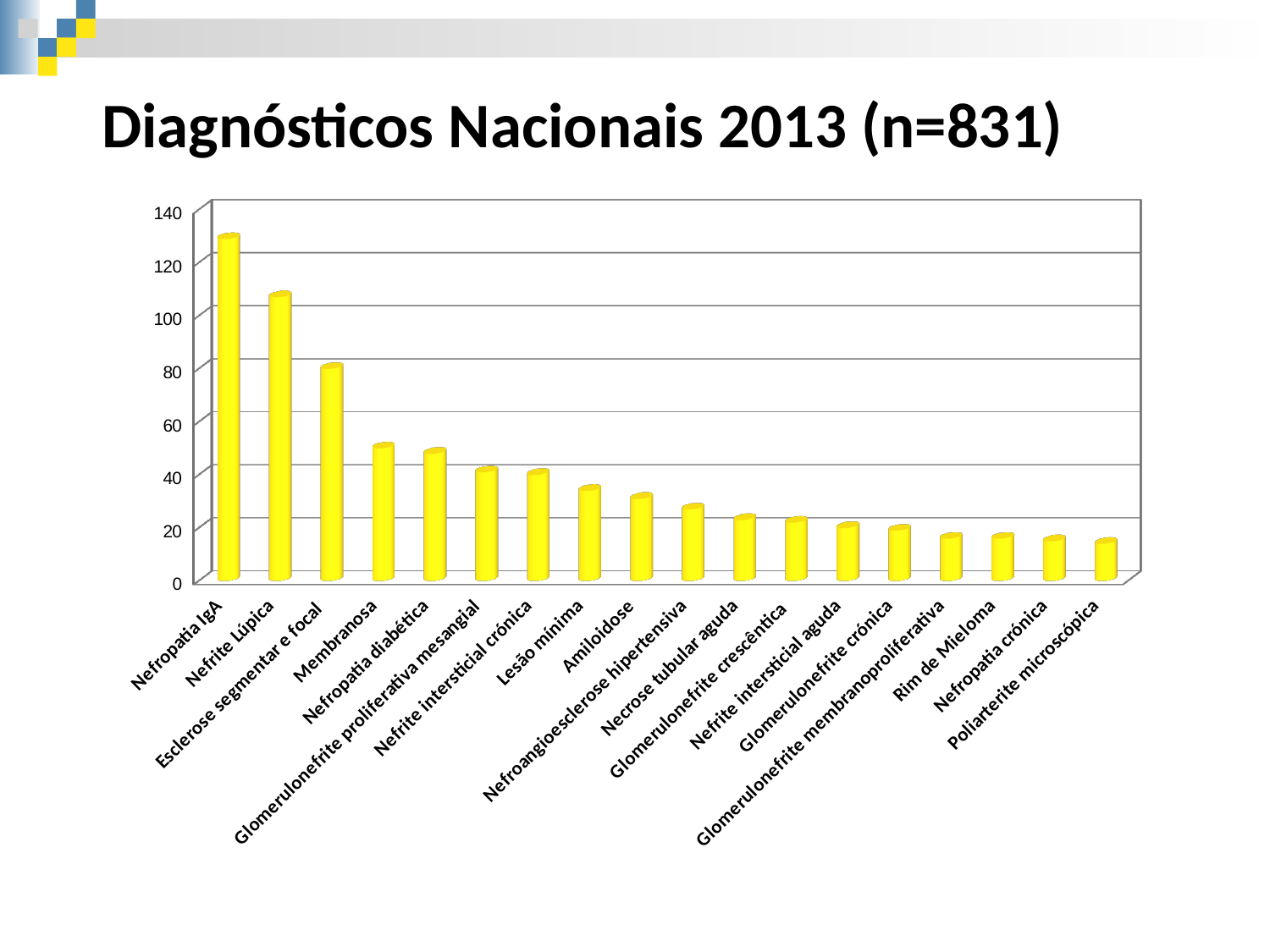
Is the value for Amiloidose greater or less than 40? less What is the title of the chart? Diagnósticos Nacionais 2013 (n=831) Is the value for Nefropatia IgA greater or less than 120? greater Do the values rise or fall moving from left to right along the x axis? fall Is the value for Membranosa greater or less than 40? greater Which diagnosis has the highest value? Nefropatia IgA What kind of chart is shown on the slide? bar chart How many diagnosis categories are plotted on the chart? 18 Which is larger, the value for Nefrite Lúpica or the value for Membranosa? Nefrite Lúpica